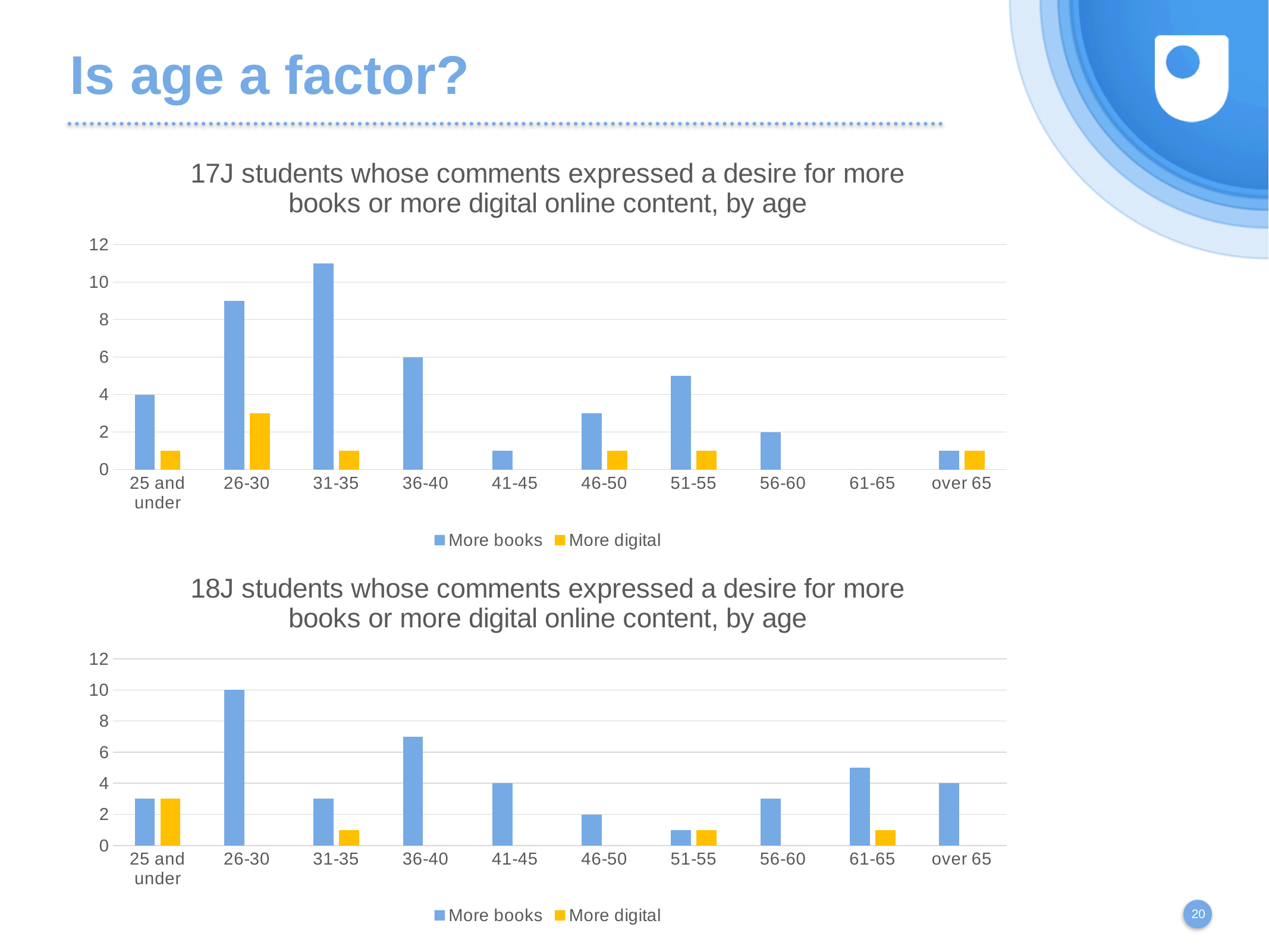
How many series does the legend of the top chart (17J students) list? 2 In the top chart (17J students), which is larger, the More books value for 26-30 or for 36-40? 26-30 In the bottom chart (18J students), which age group has the highest More books value? 26-30 In the bottom chart (18J students), what is the value for More books in the over 65 age group? 4 In the top chart (17J students), what is the value for More books in the 25 and under age group? 4 In the top chart (17J students), is the More books value for 31-35 greater or less than 10? greater In the bottom chart (18J students), is the More books value for 36-40 greater or less than 6? greater In the top chart (17J students), which age group has the highest More books value? 31-35 In the top chart (17J students), what is the value for More books in the 36-40 age group? 6 In the top chart (17J students), what is the difference between the More books values for 36-40 and 25 and under? 2 How many age groups are shown on the x axis of the bottom chart (18J students)? 10 In the bottom chart (18J students), what is the value for More books in the 26-30 age group? 10